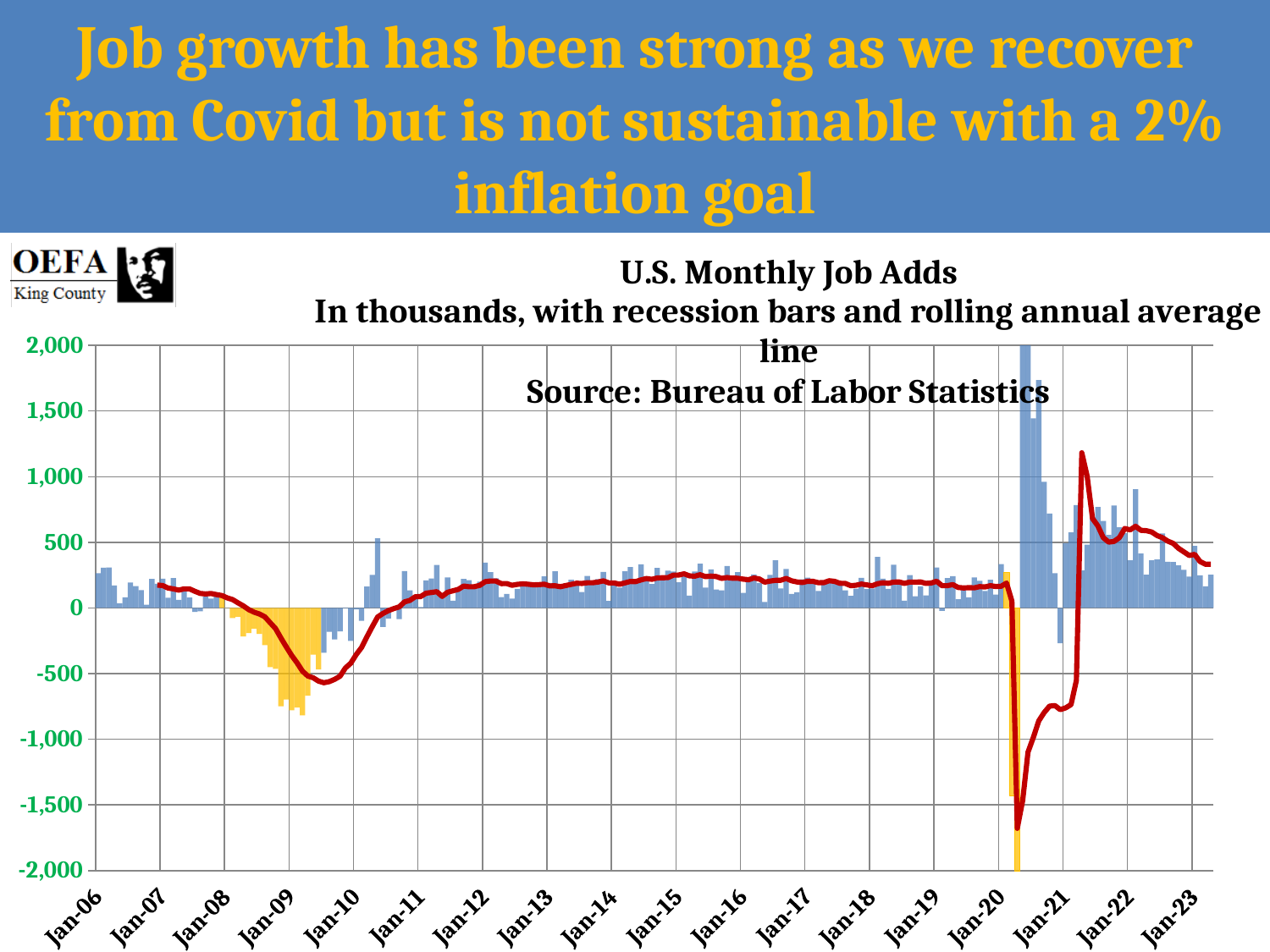
What kind of chart is shown on the slide? A bar chart with a line overlay What is the title of the chart? U.S. Monthly Job Adds Is the lowest point of the rolling annual average line, reached in 2020, greater or less than -1,500? less How many year labels are shown on the x axis, from Jan-06 to Jan-23? 18 Is the value of the rolling annual average line at Jan-15 greater or less than 500? less Does the rolling annual average line rise or fall between Jan-22 and Jan-23? fall In which year does the rolling annual average line reach its lowest point? 2020 Is the value of the rolling annual average line at Jan-23 greater or less than 0? greater What source is cited for the chart's data? Bureau of Labor Statistics What is the highest value shown on the y axis? 2,000 What is the lowest value shown on the y axis? -2,000